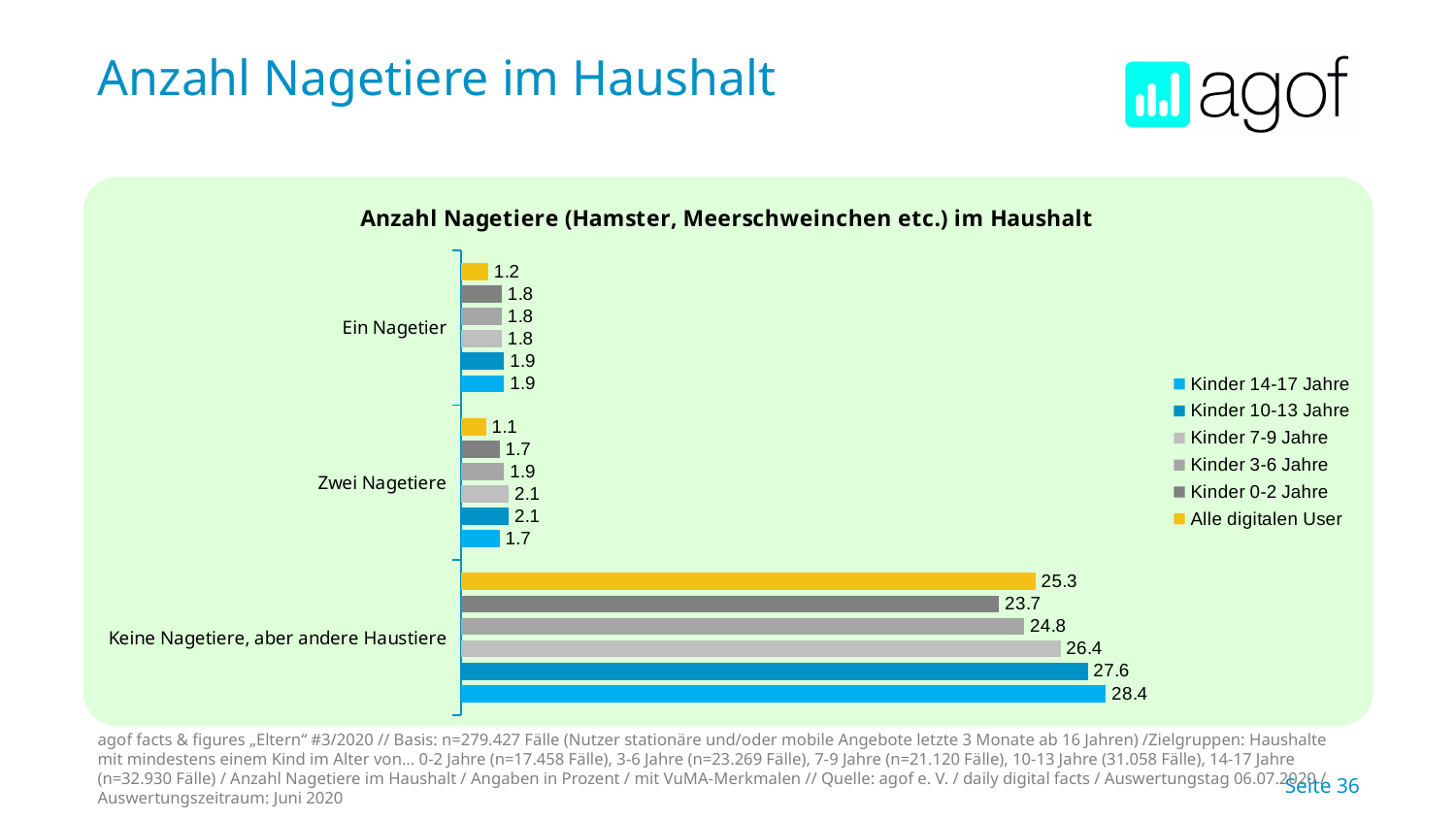
What is the value for Kinder 10-13 Jahre in the category Keine Nagetiere, aber andere Haustiere? 27.6 What is the value for Alle digitalen User in the category Keine Nagetiere, aber andere Haustiere? 25.3 What is the title of the chart? Anzahl Nagetiere (Hamster, Meerschweinchen etc.) im Haushalt How many categories are shown on the chart? 3 Which series has the highest value in the category Keine Nagetiere, aber andere Haustiere? Kinder 14-17 Jahre How many series does the legend list? 6 Which series has the lowest value in the category Zwei Nagetiere? Alle digitalen User In the category Keine Nagetiere, aber andere Haustiere, which is larger: Kinder 7-9 Jahre or Kinder 3-6 Jahre? Kinder 7-9 Jahre What is the value for Kinder 14-17 Jahre in the category Ein Nagetier? 1.9 What is the value for Kinder 0-2 Jahre in the category Zwei Nagetiere? 1.7 What type of chart is shown on the slide? bar chart What is the difference between Kinder 14-17 Jahre and Kinder 0-2 Jahre in the category Keine Nagetiere, aber andere Haustiere? 4.7